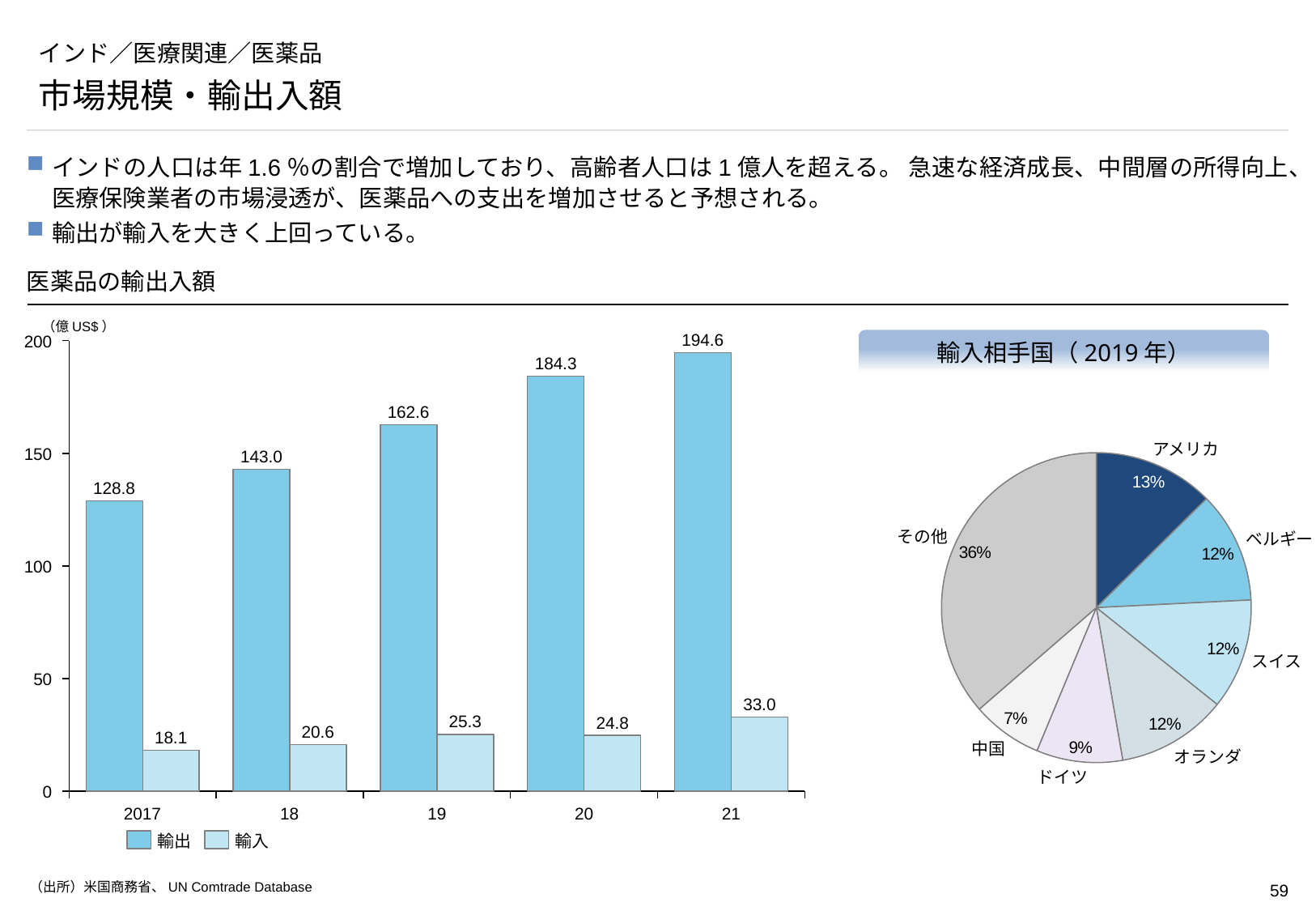
In the bar chart 医薬品の輸出入額, which year has the lowest 輸入 value? 2017 In the bar chart 医薬品の輸出入額, how many years are shown on the x axis? 5 What kind of chart is 輸入相手国（2019年）? pie chart In the bar chart 医薬品の輸出入額, which is larger: 輸入 in 2019 or 輸入 in 2020? 輸入 in 2019 In the pie chart 輸入相手国（2019年）, what share does アメリカ have? 13% In the bar chart 医薬品の輸出入額, what is the value of 輸入 in 2017? 18.1 In the pie chart 輸入相手国（2019年）, which slice is the largest? その他 In the bar chart 医薬品の輸出入額, what is the difference between 輸出 and 輸入 in 2019? 137.3 In the bar chart 医薬品の輸出入額, what is the value of 輸出 in 2021? 194.6 In the bar chart 医薬品の輸出入額, does the 輸出 value rise or fall from 2017 to 2021? rise In the bar chart 医薬品の輸出入額, how many series does the legend list? 2 In the bar chart 医薬品の輸出入額, which year has the highest 輸出 value? 21